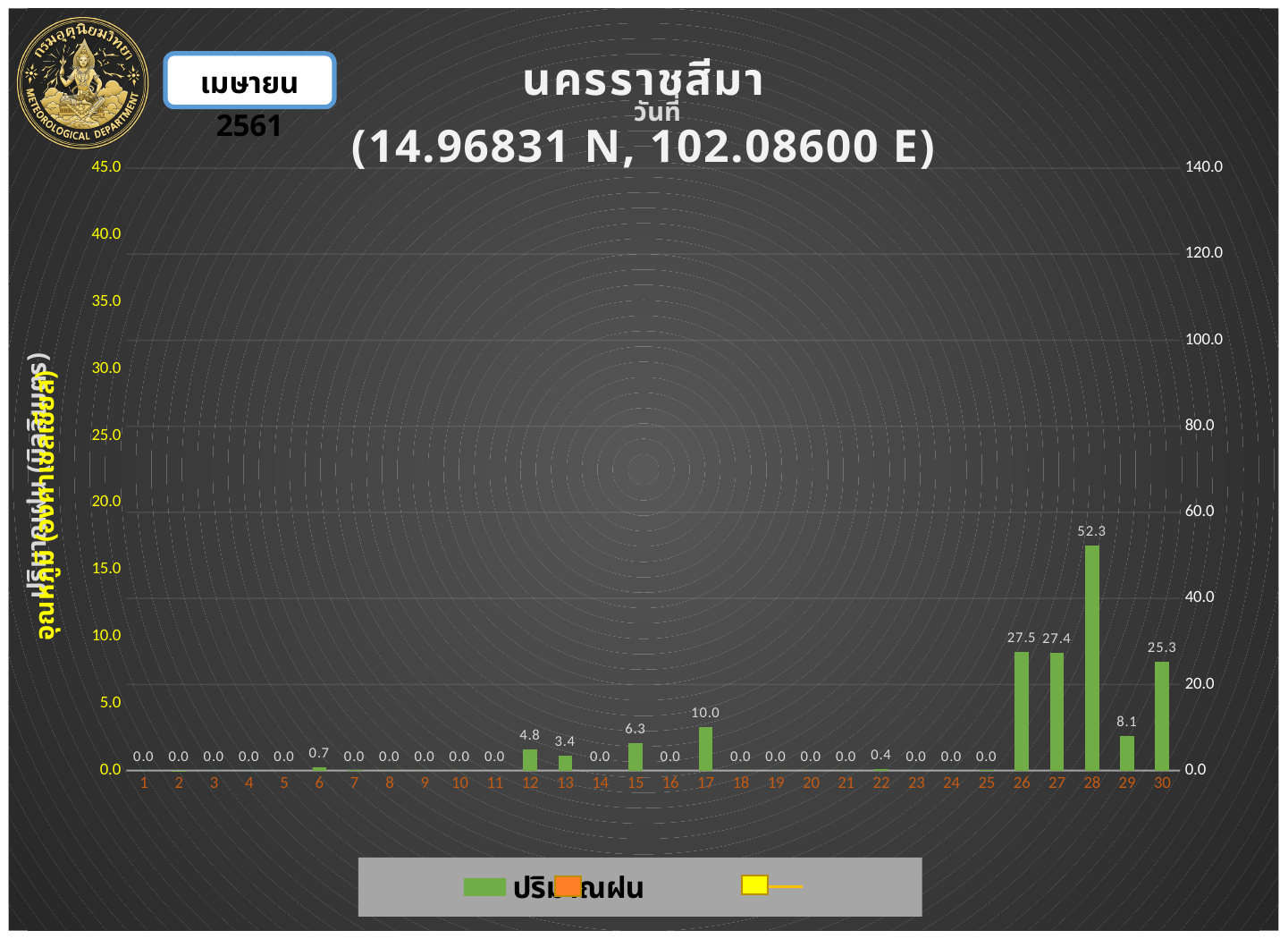
What is the rainfall value shown for day 28? 52.3 What is the rainfall value shown for day 17? 10.0 What is the difference between the rainfall values for day 30 and day 29? 17.2 Is the rainfall value for day 28 greater or less than 40.0 on the right axis? greater Which has a larger rainfall value, day 17 or day 15? day 17 What is the rainfall value shown for day 30? 25.3 Which day has the highest rainfall value? 28 What kind of chart is shown on the slide? bar chart Do the rainfall values rise or fall from day 28 to day 29? fall What is the difference between the rainfall values for day 28 and day 26? 24.8 How many days are shown on the x axis? 30 What is the rainfall value shown for day 12? 4.8